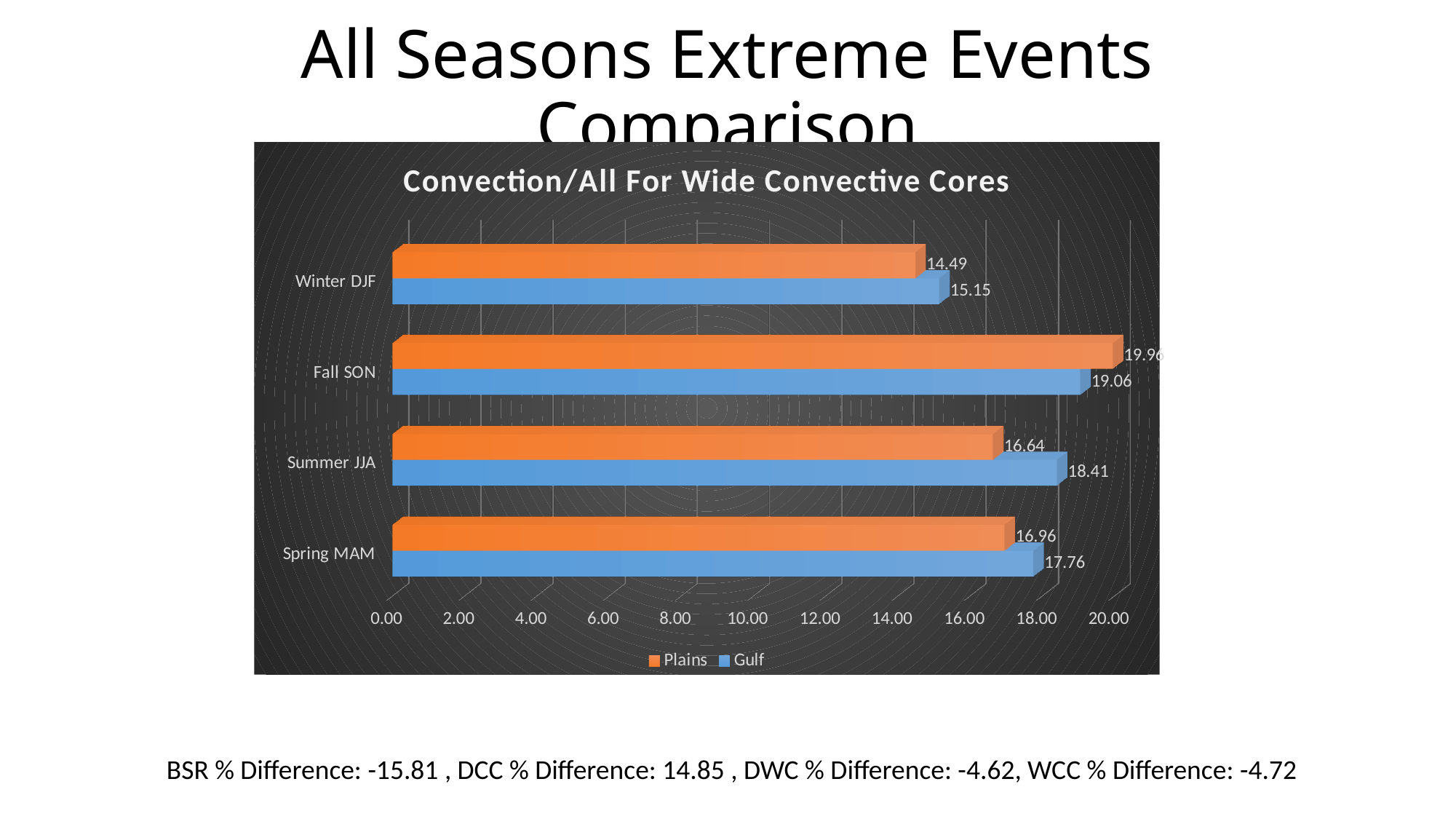
How many series does the legend list? 2 What is the Gulf value for Summer JJA? 18.41 Which season has the highest Plains value? Fall SON Which season has the lowest Gulf value? Winter DJF What type of chart is shown? bar chart How many seasons are shown on the chart? 4 Is the Plains value for Winter DJF greater or less than 16.00? less What is the Plains value for Spring MAM? 16.96 What is the Plains value for Fall SON? 19.96 Which is larger for Fall SON, the Plains value or the Gulf value? Plains What is the difference between the Gulf and Plains values for Summer JJA? 1.77 What is the Gulf value for Winter DJF? 15.15